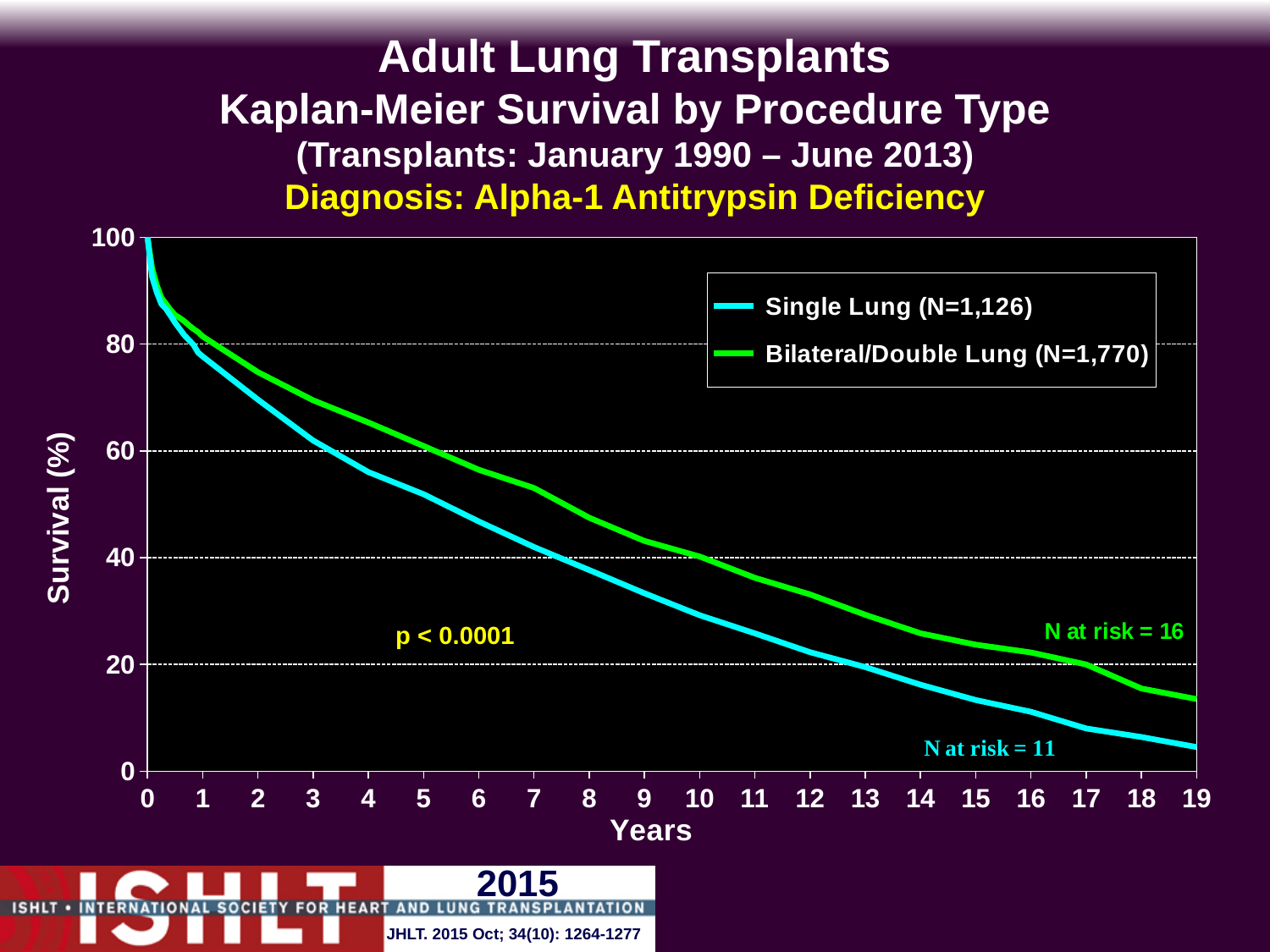
What is the N for the Bilateral/Double Lung group shown in the legend? 1,770 What kind of chart is shown on the slide? line chart Is the survival for Bilateral/Double Lung at 7 years greater or less than 60? less What is the N at risk value printed for the Bilateral/Double Lung curve? 16 What p-value is printed on the chart? p < 0.0001 What is the N at risk value printed for the Single Lung curve? 11 What is the N for the Single Lung group shown in the legend? 1,126 Do the survival curves rise or fall as years increase? fall Is the survival for Single Lung at 10 years greater or less than 40? less Is the survival for Single Lung at 15 years greater or less than 20? less At 10 years, which group has higher survival, Single Lung or Bilateral/Double Lung? Bilateral/Double Lung How many series does the legend list? 2